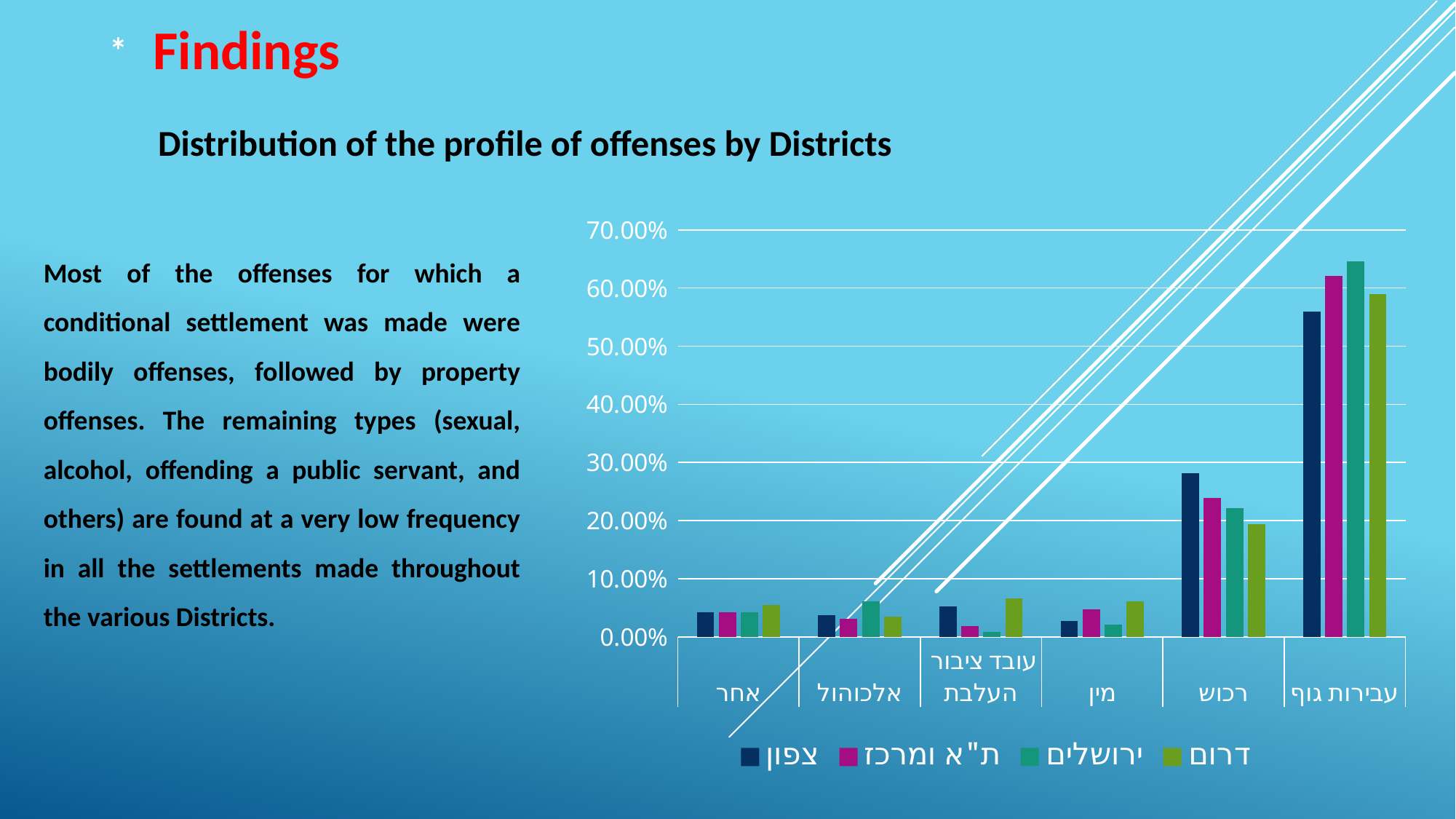
Is the value for ירושלים in the עבירות גוף category greater or less than 60.00%? greater Is the value for צפון in the רכוש category greater or less than 30.00%? less In the רכוש category, which is larger: the value for צפון or the value for דרום? צפון Is the value for צפון in the עבירות גוף category greater or less than 50.00%? greater What kind of chart is shown on the slide? bar chart Which offense category has the highest values across all districts? עבירות גוף What is the title of the chart on the slide? Distribution of the profile of offenses by Districts How many series does the chart legend list? 4 Which district has the highest value in the רכוש category? צפון How many offense categories are shown on the x axis of the chart? 6 In the עבירות גוף category, which is larger: the value for ירושלים or the value for צפון? ירושלים